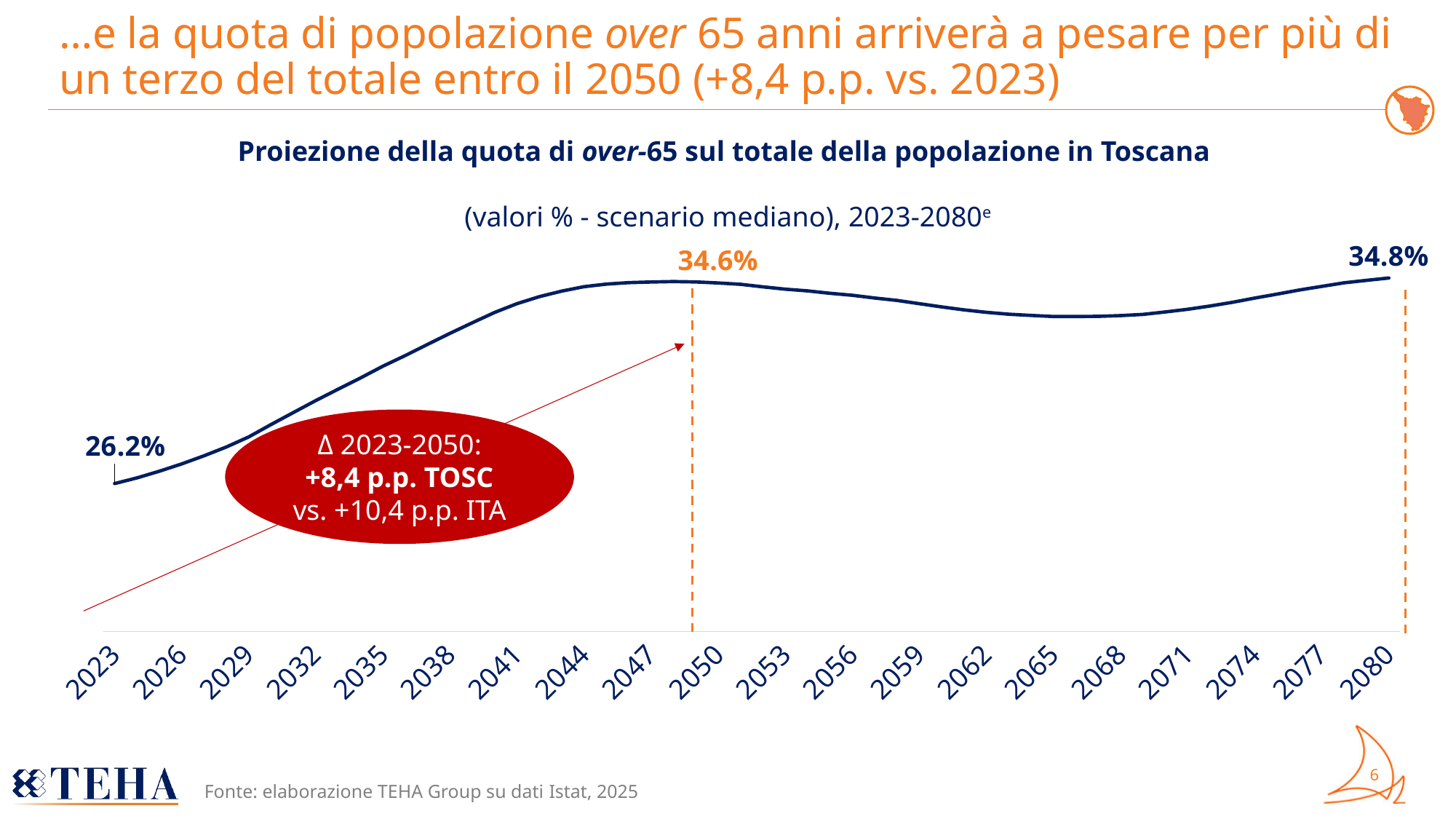
How many year labels are shown on the x axis? 20 Which of the labelled years has the highest over-65 share? 2080 What is the projected share of over-65 population in Toscana in 2080? 34.8% What is the change in percentage points for Italy (ITA) between 2023 and 2050 shown in the red callout? +10,4 p.p. What kind of chart is shown on the slide? Line chart By how many percentage points does the over-65 share in Toscana change between 2023 and 2050? +8,4 p.p. What is the projected share of over-65 population in Toscana in 2050? 34.6% What is the difference between the 2080 value and the 2050 value? 0.2 percentage points Which is larger, the value for 2050 or the value for 2080? 2080 What is the projected share of over-65 population in Toscana in 2023? 26.2% Does the over-65 share rise or fall between 2023 and 2050? Rise Which of the labelled years has the lowest over-65 share? 2023